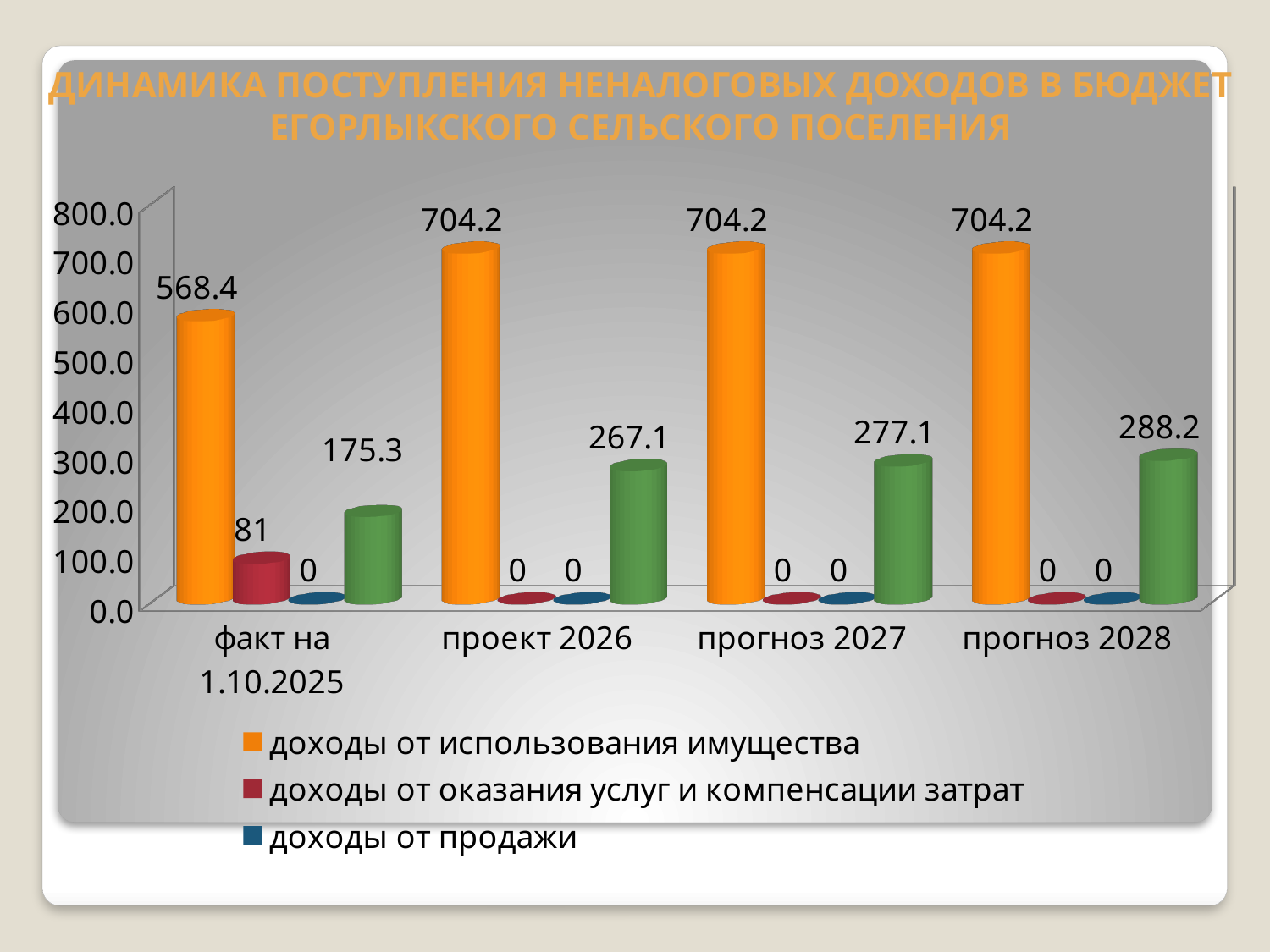
What is the difference between доходы от использования имущества for проект 2026 and for факт на 1.10.2025? 135.8 How many categories are shown on the x axis? 4 What is the value of доходы от оказания услуг и компенсации затрат for факт на 1.10.2025? 81 What kind of chart is shown on the slide? bar chart What is the value of доходы от использования имущества for факт на 1.10.2025? 568.4 What is the value of доходы от использования имущества for проект 2026? 704.2 Do the values of доходы от оказания услуг и компенсации затрат rise or fall from факт на 1.10.2025 to проект 2026? fall Which is larger: доходы от использования имущества for факт на 1.10.2025 or for прогноз 2028? прогноз 2028 How many series does the legend list? 3 Is the value of доходы от использования имущества for прогноз 2027 greater or less than 600.0? greater What is the value of доходы от продажи for прогноз 2027? 0 Which category has the lowest value for доходы от использования имущества? факт на 1.10.2025